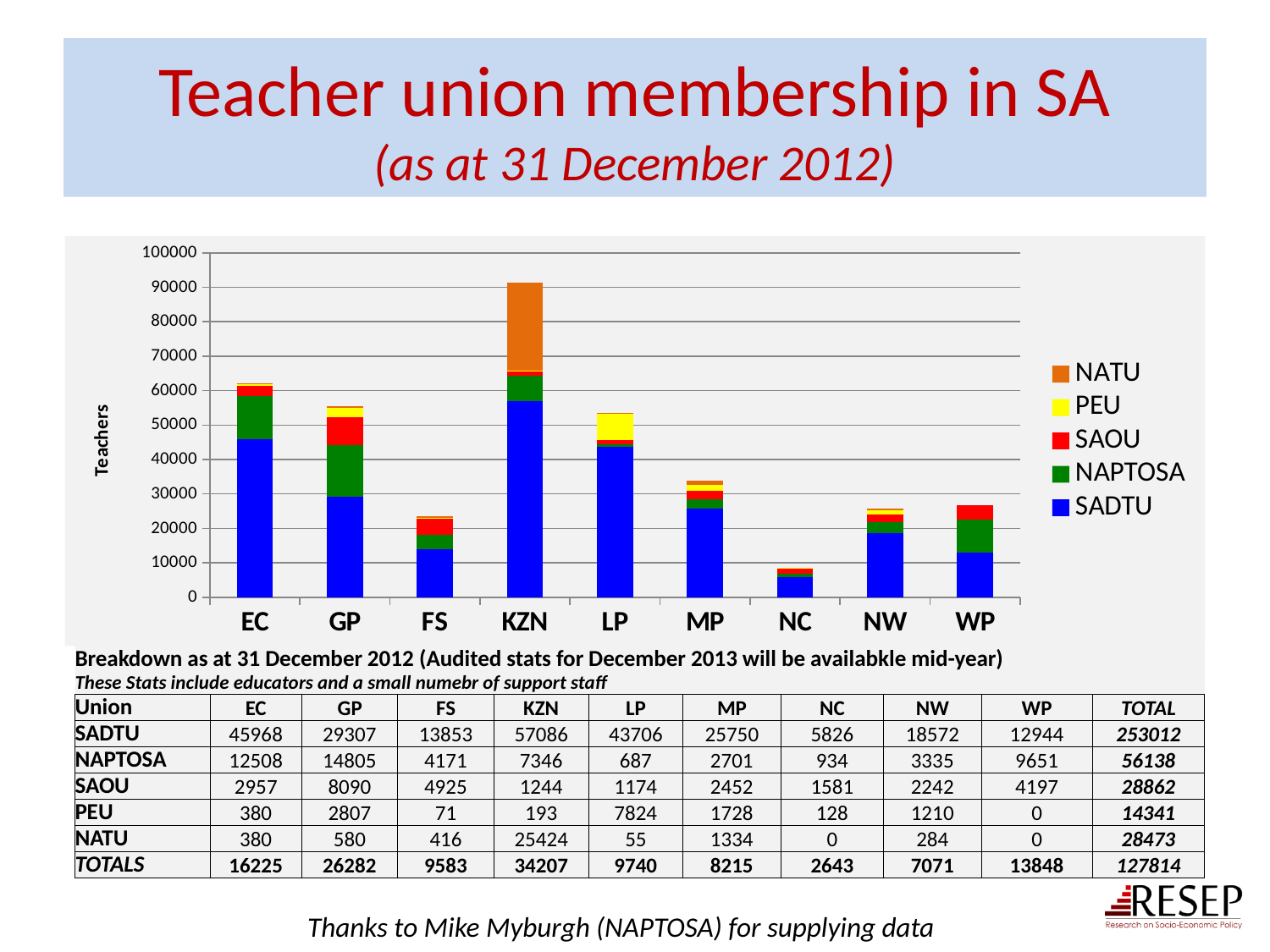
Which province has the shortest stacked bar? NC What type of chart is shown on the slide? Stacked bar chart What is the difference between SADTU membership in EC and in GP? 16661 Which union forms the bottom segment of each stacked bar? SADTU How many provinces are shown on the x axis of the chart? 9 How many unions are listed in the chart legend? 5 What is the PEU membership in LP? 7824 Which province has the tallest stacked bar? KZN Which province has the larger NAPTOSA membership, GP or EC? GP Is the SADTU value for LP greater or less than 40000? greater What is the NATU membership in KZN? 25424 What is the SADTU membership in KZN? 57086